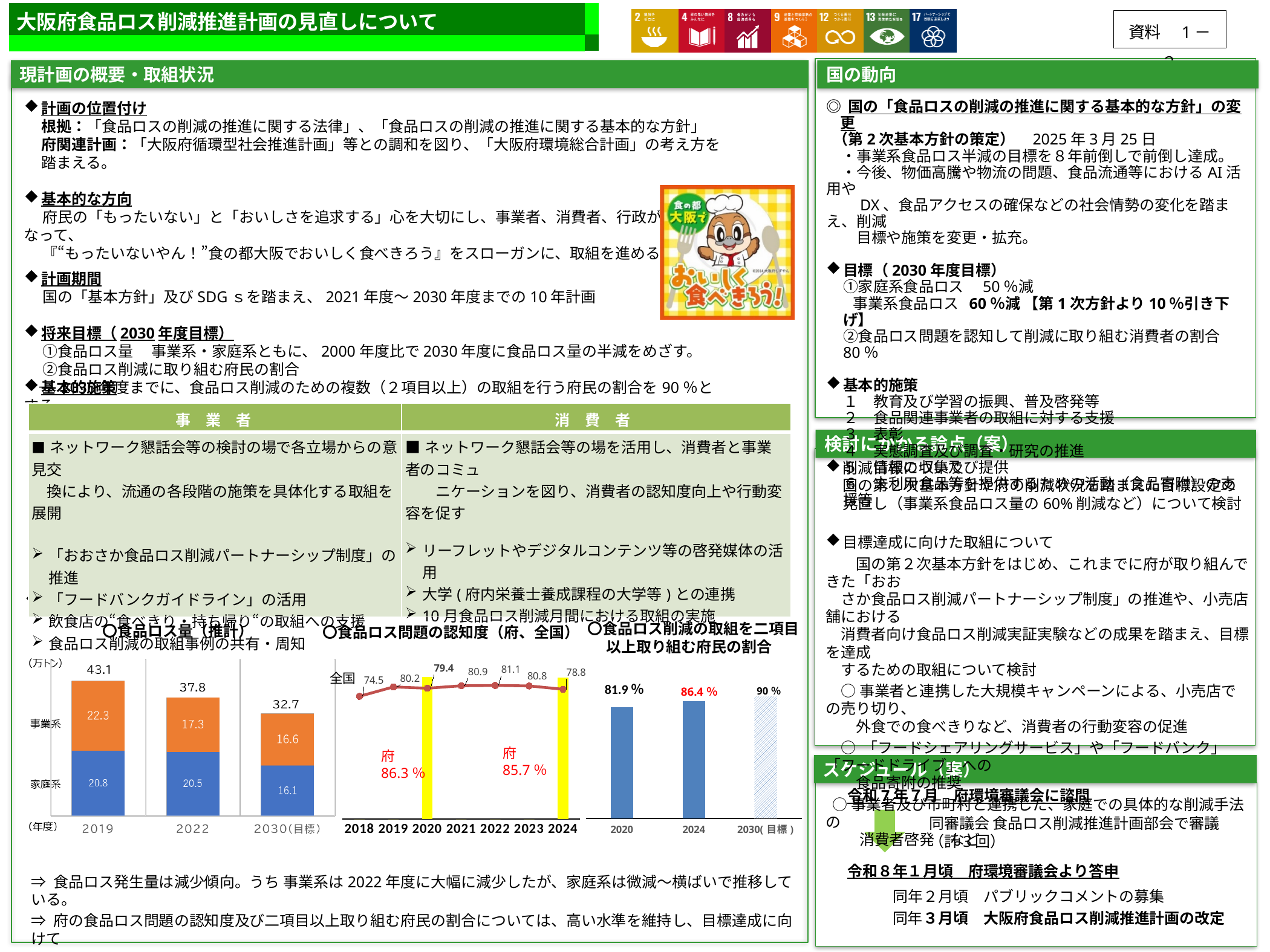
In the 食品ロス削減の取組を二項目以上取り組む府民の割合 chart, what is the difference between the 2030(目標) value and the 2020 value? 8.1％ In the 食品ロス問題の認知度（府、全国） chart, how many years are shown on the x axis? 7 In the 食品ロス量（推計） chart, what is the total food loss for 2019? 43.1 In the 食品ロス削減の取組を二項目以上取り組む府民の割合 chart, what is the value for 2024? 86.4％ In the 食品ロス量（推計） chart, do the totals rise or fall from 2019 to 2030(目標)? Fall In the 食品ロス問題の認知度（府、全国） chart, what is the 府 value for 2020? 86.3％ In the 食品ロス問題の認知度（府、全国） chart, what is the 全国 value for 2018? 74.5 In the 食品ロス量（推計） chart, what kind of chart is used? Stacked bar chart In the 食品ロス量（推計） chart, what is the 家庭系 value for 2030(目標)? 16.1 In the 食品ロス問題の認知度（府、全国） chart, which year has the highest 全国 value? 2022 In the 食品ロス量（推計） chart, what is the difference between the 2019 total and the 2022 total? 5.3 In the 食品ロス量（推計） chart, what is the 事業系 value for 2022? 17.3